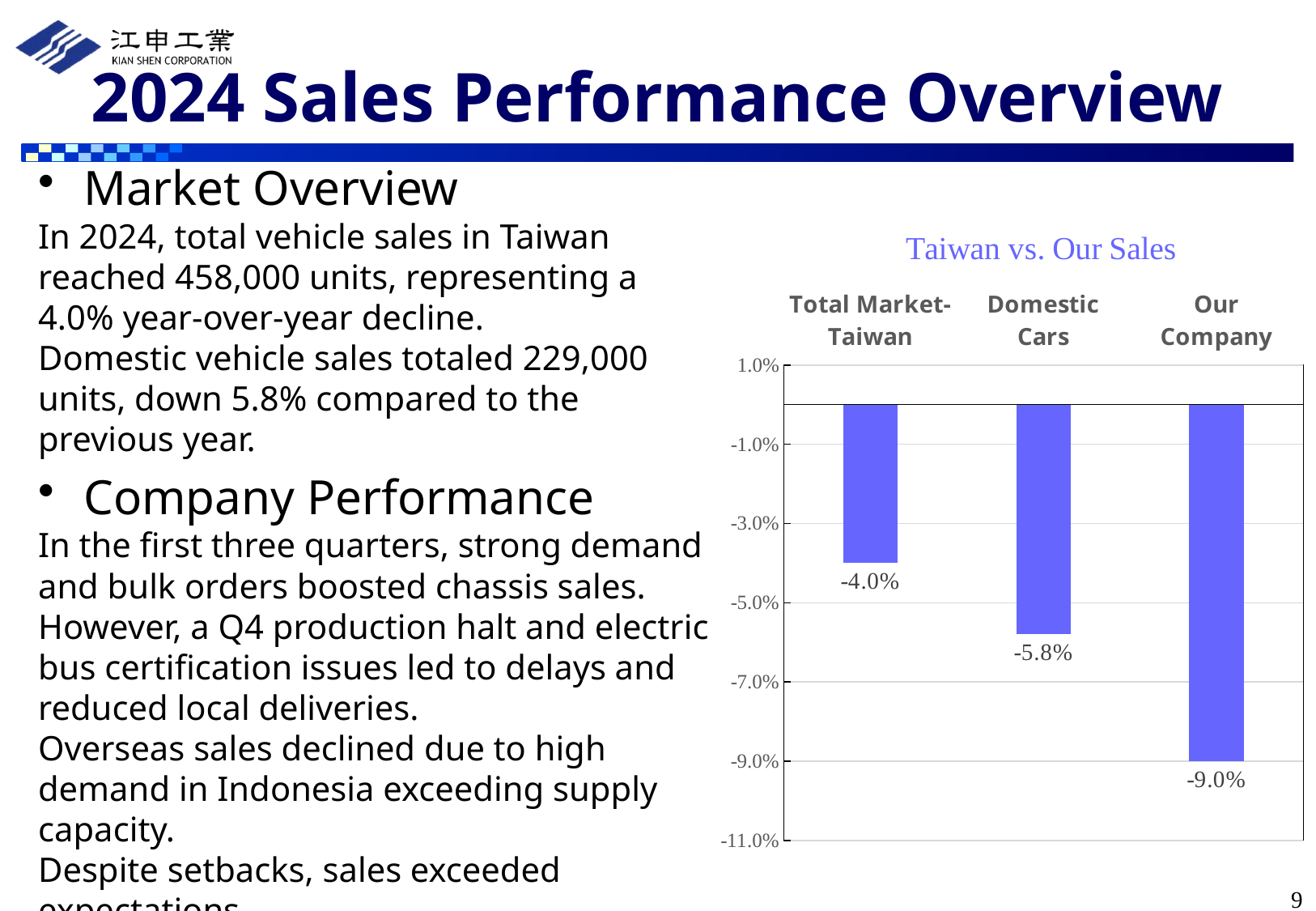
What is the value for Domestic Cars in the chart? -5.8% What is the title of the chart? Taiwan vs. Our Sales What is the difference between the values for Domestic Cars and Total Market-Taiwan? 1.8 percentage points What is the value for Total Market-Taiwan in the chart? -4.0% Is the value for Our Company greater or less than -7.0%? less Which category has the highest value in the chart? Total Market-Taiwan How many categories are shown in the chart? 3 What is the difference between the values for Total Market-Taiwan and Our Company? 5.0 percentage points Which is larger, the value for Domestic Cars or the value for Our Company? Domestic Cars What kind of chart is shown on the slide? bar chart What is the value for Our Company in the chart? -9.0% Which category has the lowest value in the chart? Our Company